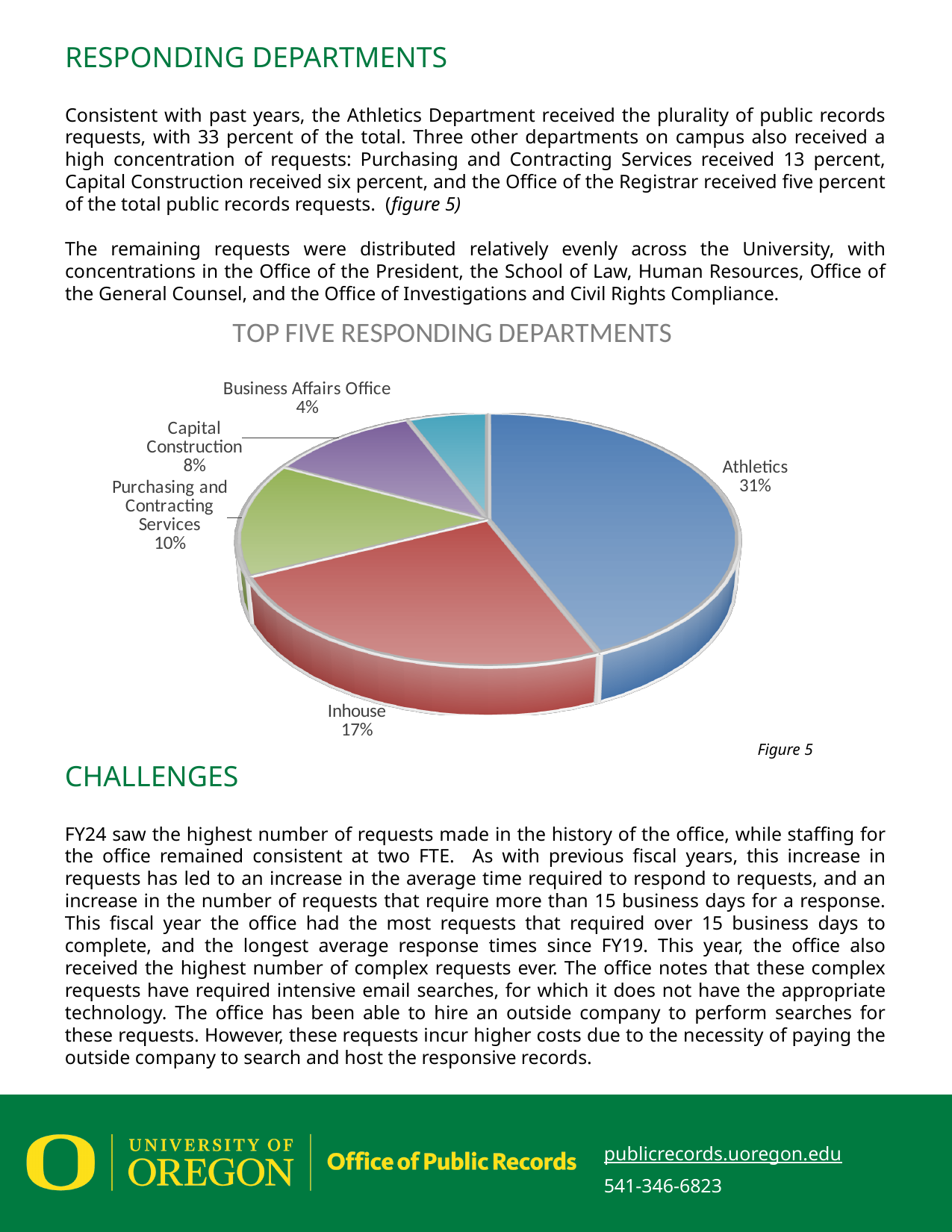
Which is larger, the slice for Capital Construction or the slice for Purchasing and Contracting Services? Purchasing and Contracting Services Which department has the smallest slice of the pie? Business Affairs Office What type of chart is shown under the title "TOP FIVE RESPONDING DEPARTMENTS"? Pie chart What percentage is shown for Purchasing and Contracting Services? 10% How many slices does the pie chart have? 5 What percentage is shown for Capital Construction? 8% What percentage is shown for the Business Affairs Office? 4% Which department has the largest slice of the pie? Athletics What percentage is shown for Inhouse? 17% What is the title of the pie chart? TOP FIVE RESPONDING DEPARTMENTS What percentage of the pie does Athletics account for? 31% What is the difference in percentage points between Athletics and Inhouse? 14